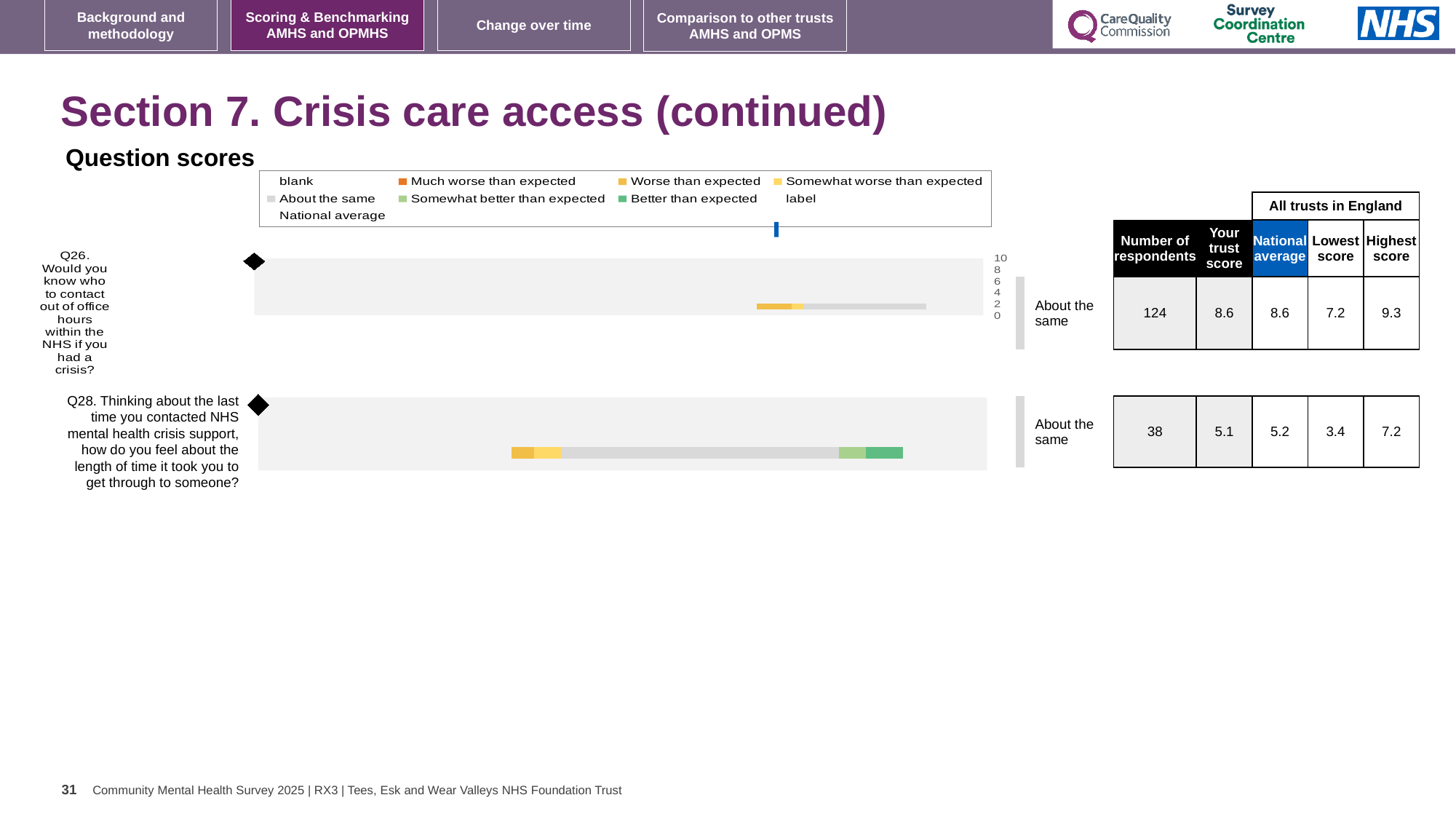
How many respondents answered Q28? 38 What is the trust score for Q26 (Would you know who to contact out of office hours within the NHS if you had a crisis?)? 8.6 Which question has the higher trust score, Q26 or Q28? Q26 What kind of chart is used to show the question scores on this slide? bar chart What is the difference between the highest score and the lowest score across all trusts for Q26? 2.1 What is the difference between the highest score and the lowest score across all trusts for Q28? 3.8 What is the national average for Q28? 5.2 What benchmark category label is shown next to the bar for Q28? About the same How many questions are plotted in the question scores chart? 2 How many respondents answered Q26? 124 What is the trust score for Q28 (length of time it took to get through to someone)? 5.1 What is the national average for Q26? 8.6